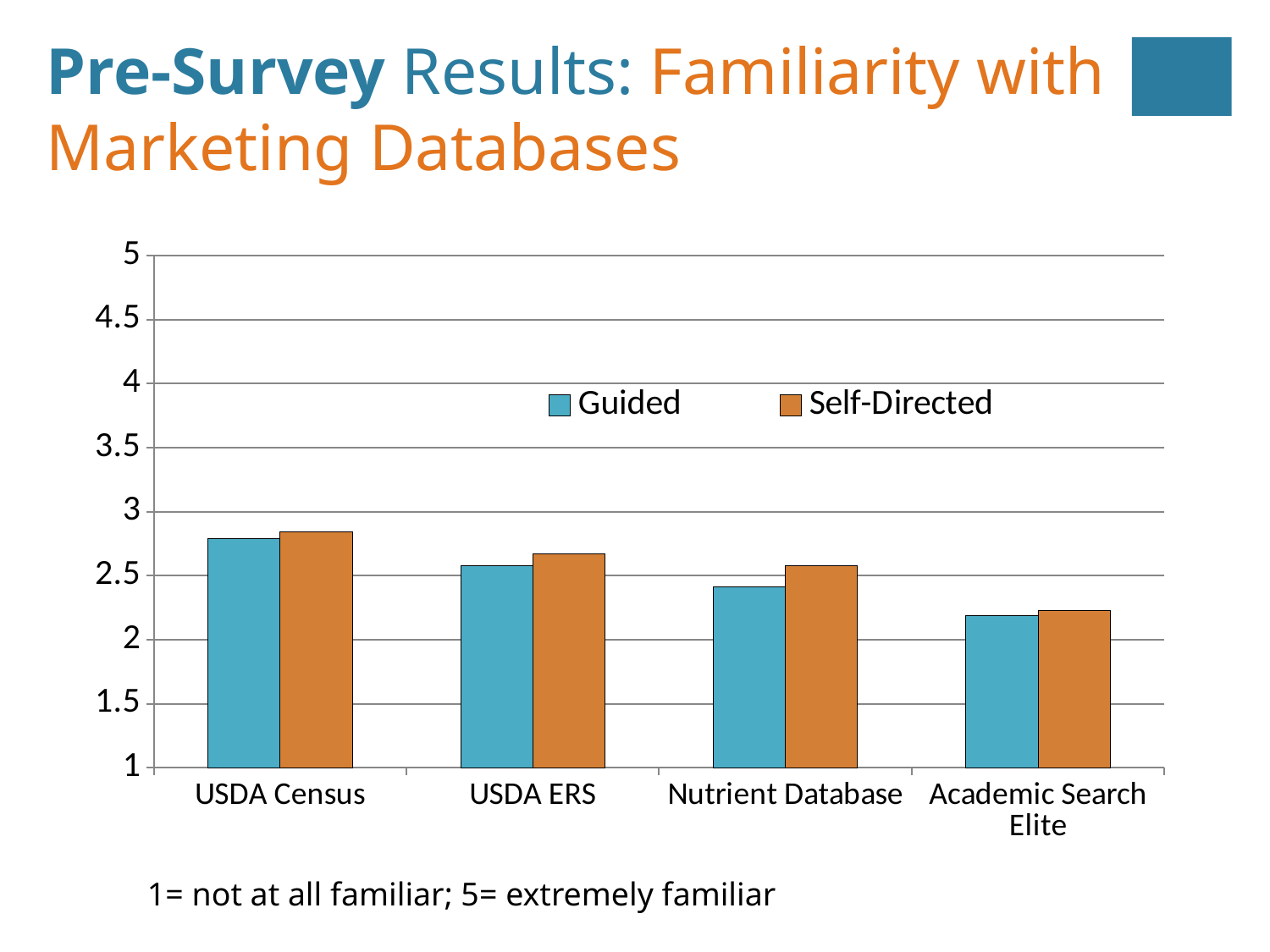
Which colour represents the Self-Directed series? orange Is the Self-Directed value for USDA ERS greater or less than 3? less Is the Self-Directed value for Academic Search Elite greater or less than 2.5? less How many database categories are shown on the x axis? 4 Which database has the lowest familiarity rating for the Self-Directed group? Academic Search Elite Is the Guided value for USDA Census greater or less than 2.5? greater Do the Self-Directed familiarity ratings rise or fall moving from USDA Census to Academic Search Elite? fall According to the note below the chart, what does a rating of 5 mean? extremely familiar What kind of chart is shown on the slide? bar chart How many series does the legend list? 2 For Nutrient Database, which group has the higher familiarity rating, Guided or Self-Directed? Self-Directed Which database has the highest familiarity rating for the Guided group? USDA Census